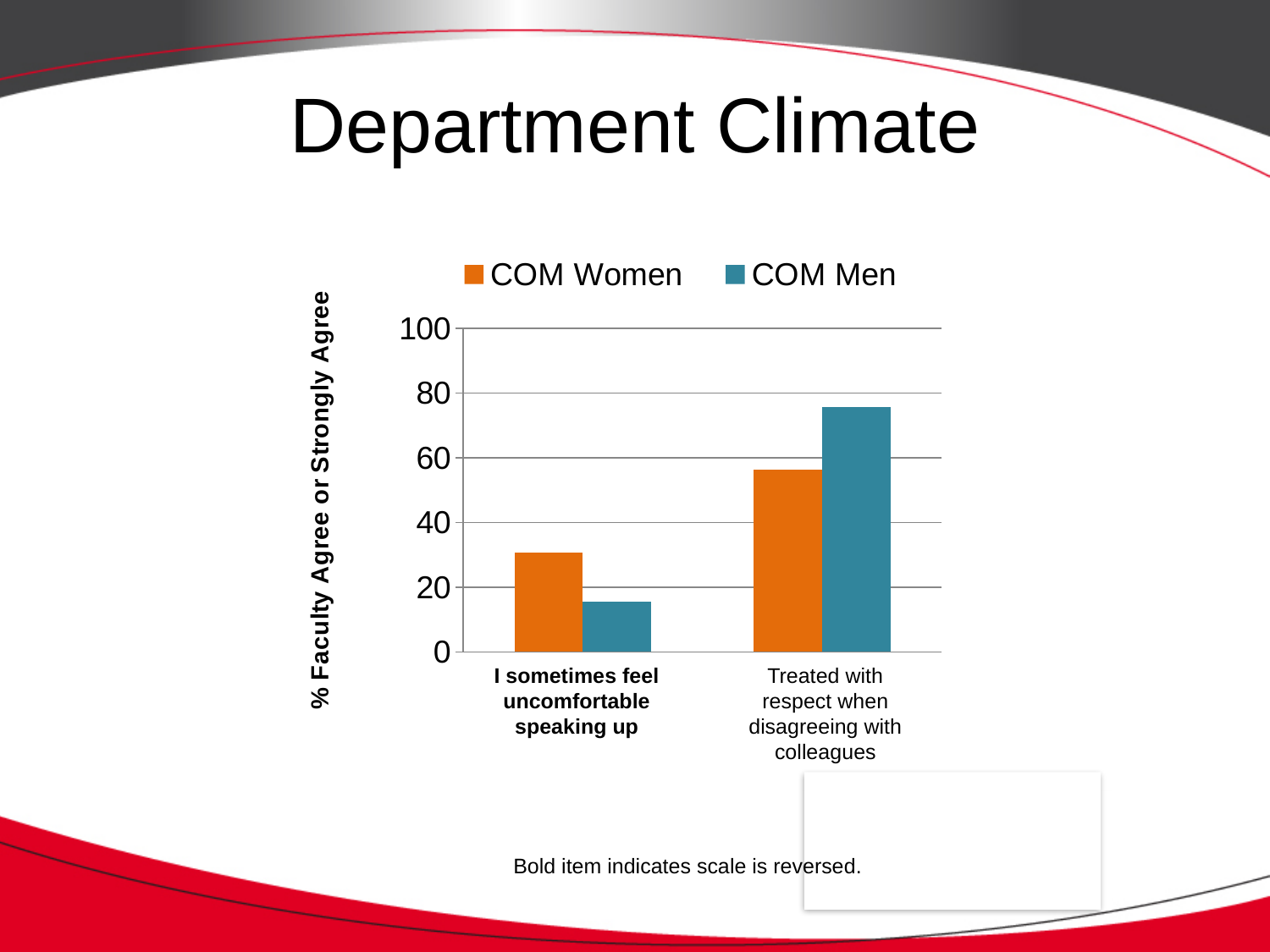
Which series has the shortest bar in the chart? COM Men Is the value for COM Men on 'I sometimes feel uncomfortable speaking up' greater or less than 20? less Is the value for COM Women on 'I sometimes feel uncomfortable speaking up' greater or less than 20? greater How many categories are shown on the x axis? 2 Is the value for COM Women on 'Treated with respect when disagreeing with colleagues' greater or less than 40? greater For 'Treated with respect when disagreeing with colleagues', which is larger: COM Women or COM Men? COM Men How many series does the legend list? 2 What is the label on the vertical axis of the chart? % Faculty Agree or Strongly Agree What kind of chart is shown on the slide? bar chart Which series has the tallest bar in the chart? COM Men For 'I sometimes feel uncomfortable speaking up', which is larger: COM Women or COM Men? COM Women